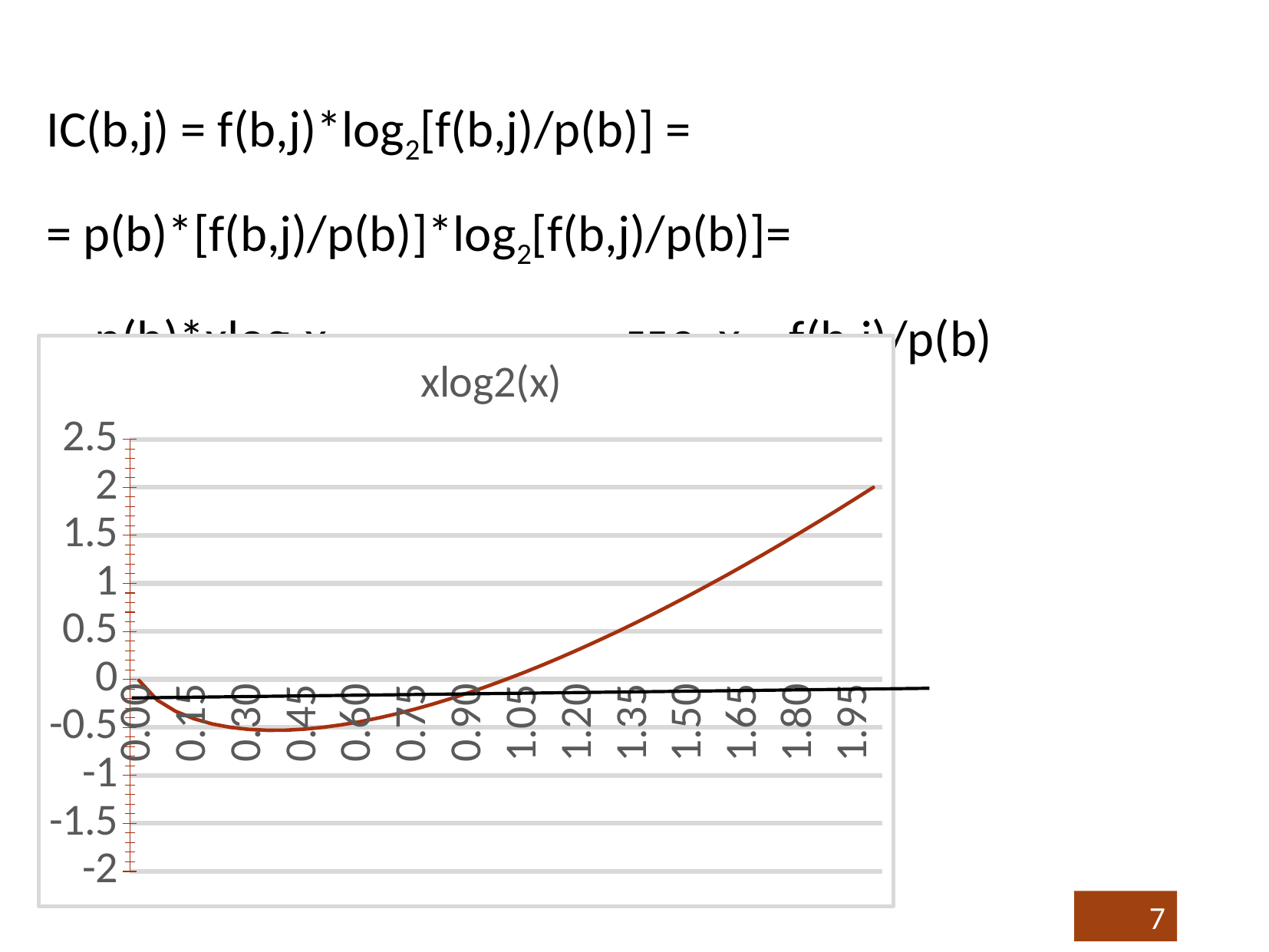
Is the value of the curve at x = 1.95 greater or less than 1.5? greater Is the value of the curve at x = 1.50 greater or less than 0.5? greater Does the curve rise or fall as x increases from 0.00 to 0.30? fall What kind of chart is shown on the slide? line chart How many labelled tick marks are on the x axis of the chart? 14 Does the curve rise or fall as x increases from 1.05 to 1.95? rise Is the value of the curve at x = 1.20 greater or less than 0.5? less What is the title of the chart? xlog2(x) Which is larger, the value of the curve at x = 0.30 or at x = 1.20? 1.20 What is the highest value labelled on the y axis of the chart? 2.5